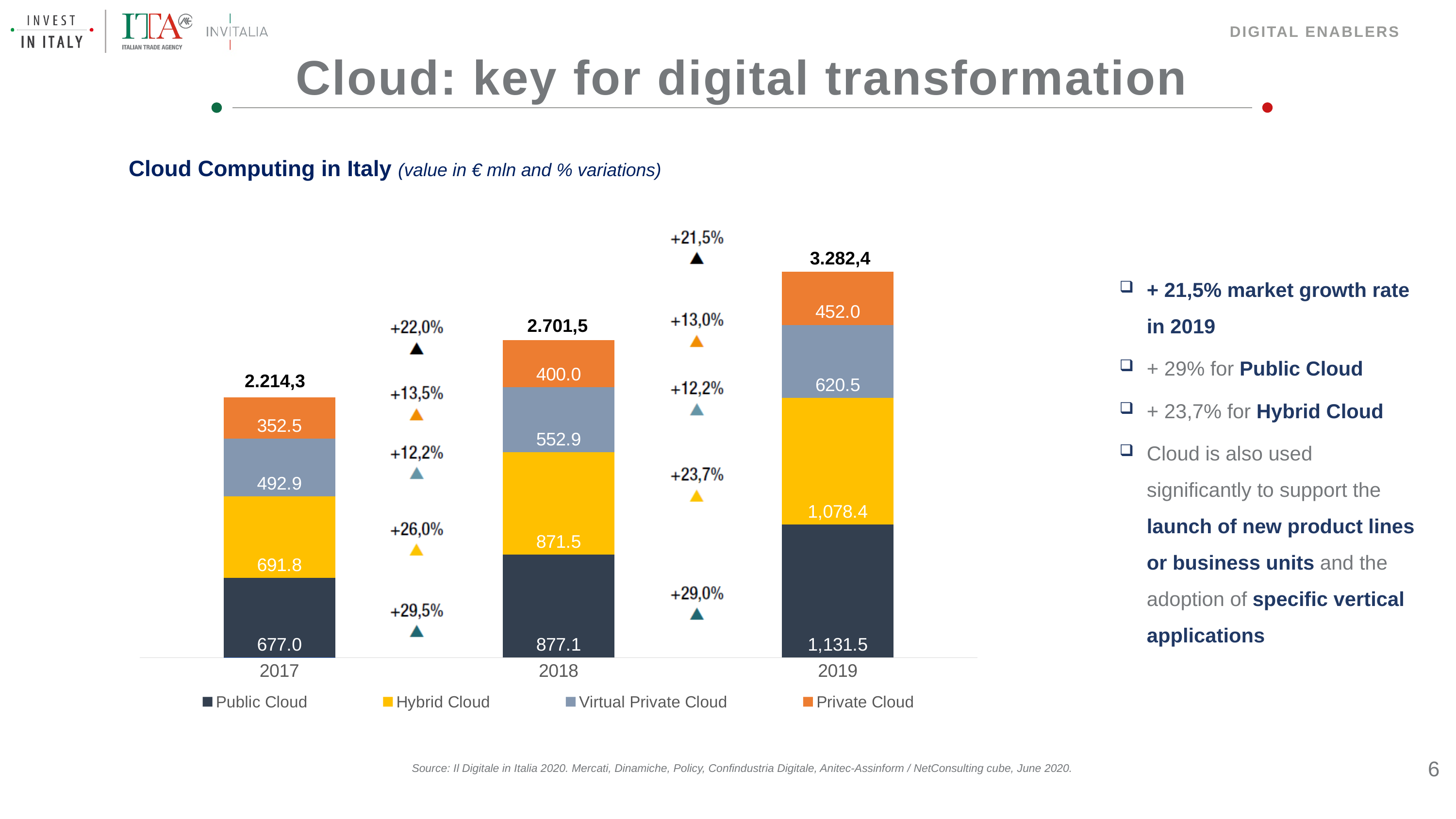
Do the total values rise or fall from 2017 to 2019? rise What is the value for Virtual Private Cloud in 2019? 620.5 In 2017, which is larger: Virtual Private Cloud or Private Cloud? Virtual Private Cloud Which year has the highest total cloud computing value? 2019 What is the value for Public Cloud in 2019? 1,131.5 What is the value for Hybrid Cloud in 2018? 871.5 What is the total of the stacked bar for 2019? 3.282,4 How many series does the legend list? 4 Which segment is the smallest in the 2018 bar? Private Cloud What is the value for Private Cloud in 2017? 352.5 How many years are shown on the x axis? 3 What is the difference between the Public Cloud values for 2019 and 2018? 254.4